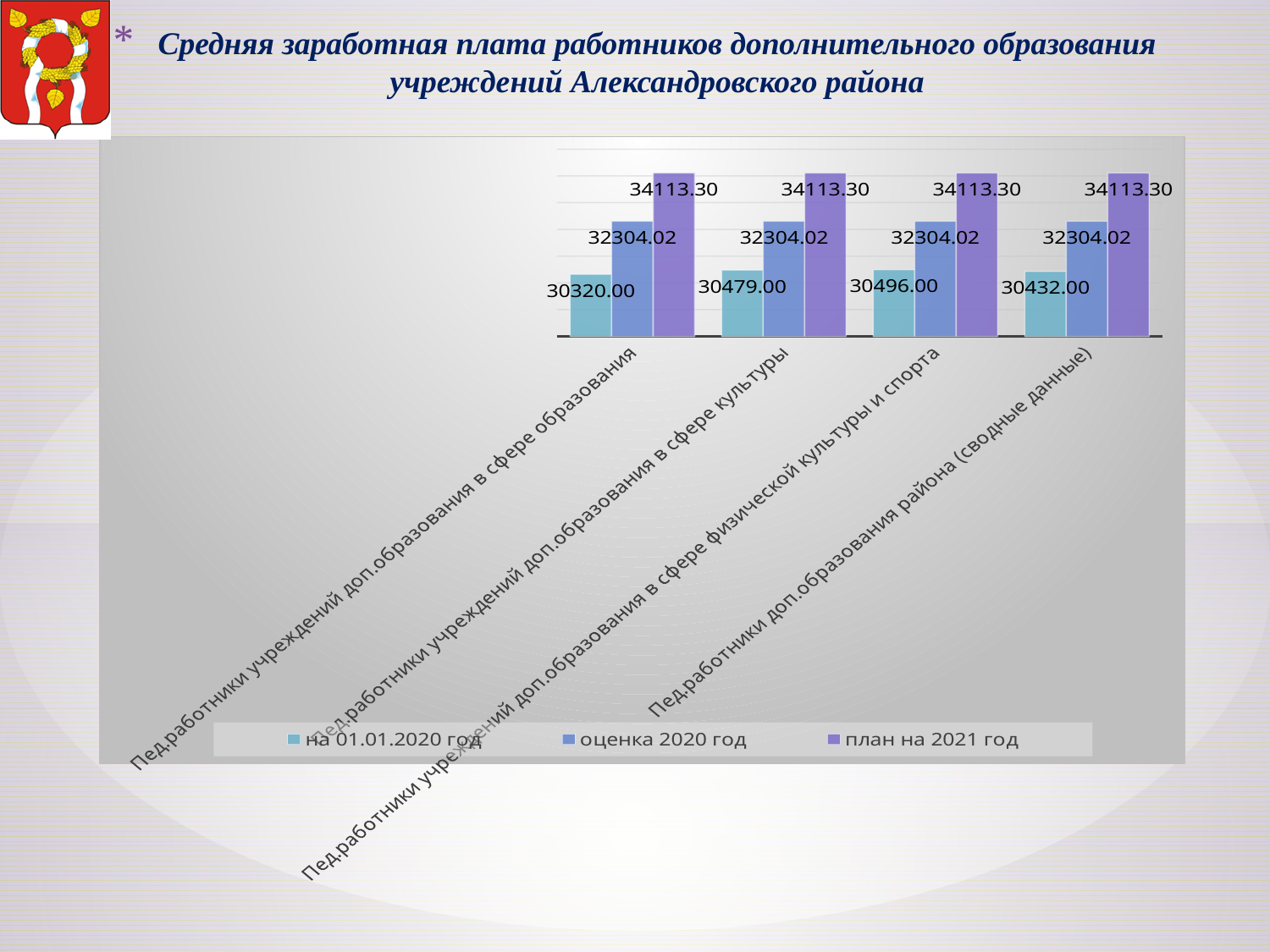
Which category has the highest value for the series 'на 01.01.2020 год'? Пед.работники учреждений доп.образования в сфере физической культуры и спорта Which category has the lowest value for the series 'на 01.01.2020 год'? Пед.работники учреждений доп.образования в сфере образования What is the value for 'на 01.01.2020 год' for the category 'Пед.работники учреждений доп.образования в сфере культуры'? 30479.00 How many series does the legend list? 3 What is the value for 'на 01.01.2020 год' for the category 'Пед.работники учреждений доп.образования в сфере физической культуры и спорта'? 30496.00 How many categories are shown on the x axis of the chart? 4 What is the difference between 'план на 2021 год' and 'оценка 2020 год' for the category 'Пед.работники учреждений доп.образования в сфере образования'? 1809.28 What is the value for 'на 01.01.2020 год' for the category 'Пед.работники доп.образования района (сводные данные)'? 30432.00 What is the value for 'план на 2021 год' for the category 'Пед.работники учреждений доп.образования в сфере культуры'? 34113.30 What kind of chart is shown on the slide? Bar chart What is the value for 'оценка 2020 год' for the category 'Пед.работники доп.образования района (сводные данные)'? 32304.02 What is the value for 'на 01.01.2020 год' for the category 'Пед.работники учреждений доп.образования в сфере образования'? 30320.00